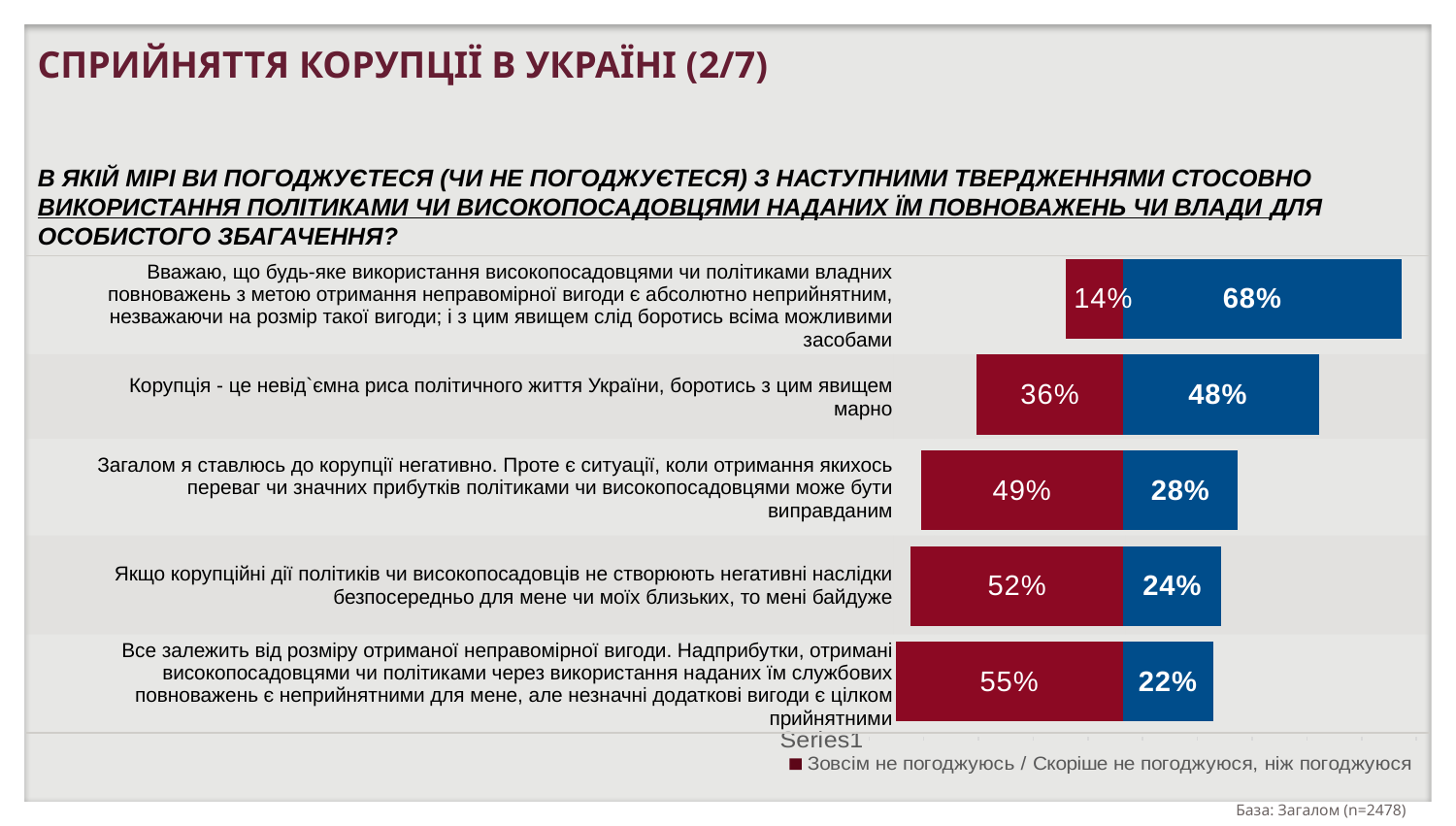
What is the blue (agree) value for the statement that any use of power by officials for improper gain is absolutely unacceptable? 68% What is the total of the red and blue values for the first statement (any use of power for improper gain is absolutely unacceptable)? 82% What kind of chart is shown on the slide? bar chart What is the red (disagree) value for the statement 'Корупція - це невід`ємна риса політичного життя України, боротись з цим явищем марно'? 36% What is the red value for the statement that corruption can sometimes be justified when it brings advantages or significant profits? 49% Which statement has the lowest blue (agree) value? Все залежить від розміру отриманої неправомірної вигоди... (22%) How many statements (categories) are plotted in the chart? 5 What is the difference between the blue and red values for the statement 'Корупція - це невід`ємна риса політичного життя України'? 12% What is the legend label shown for the red series? Зовсім не погоджуюсь / Скоріше не погоджуюся, ніж погоджуюся What is the blue value for the statement 'Якщо корупційні дії політиків чи високопосадовців не створюють негативні наслідки безпосередньо для мене чи моїх близьких, то мені байдуже'? 24% For the statement about corruption being acceptable if it has no negative consequences for me or my relatives, which is larger: the red value or the blue value? the red value (52%) Which statement has the highest red (disagree) value? Все залежить від розміру отриманої неправомірної вигоди... (55%)